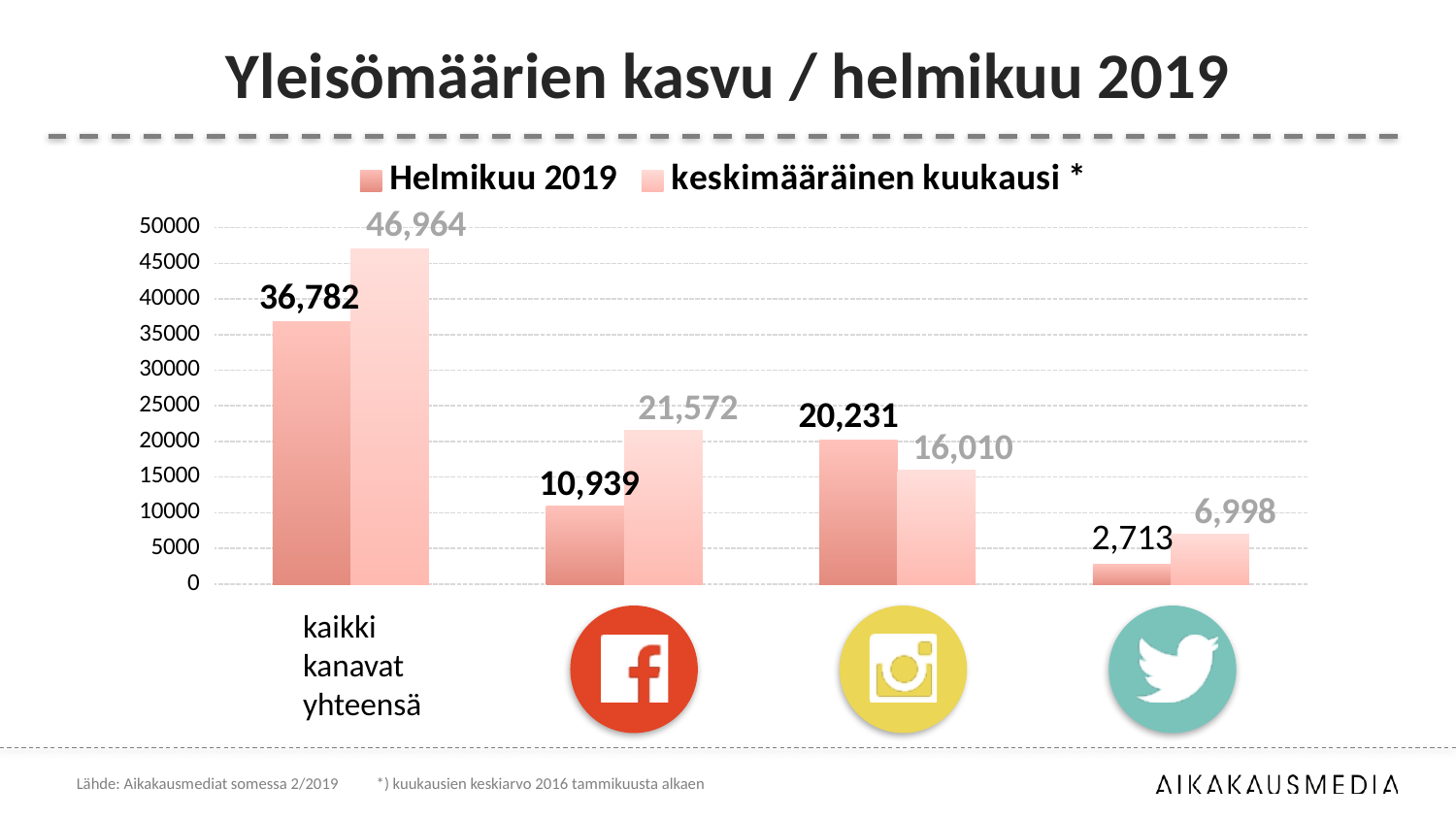
For the Instagram category, which is larger: the Helmikuu 2019 value or the keskimääräinen kuukausi value? Helmikuu 2019 What is the title of the slide? Yleisömäärien kasvu / helmikuu 2019 What is the keskimääräinen kuukausi value for the Instagram category? 16,010 What is the difference between the keskimääräinen kuukausi and Helmikuu 2019 values for the Facebook category? 10,633 How many categories are shown on the x axis? 4 What is the Helmikuu 2019 value for kaikki kanavat yhteensä? 36,782 Which category has the lowest Helmikuu 2019 value? Twitter What is the Helmikuu 2019 value for the Twitter category? 2,713 What is the keskimääräinen kuukausi value for kaikki kanavat yhteensä? 46,964 How many series does the legend list? 2 What type of chart is shown on the slide? bar chart What is the Helmikuu 2019 value for the Facebook category? 10,939